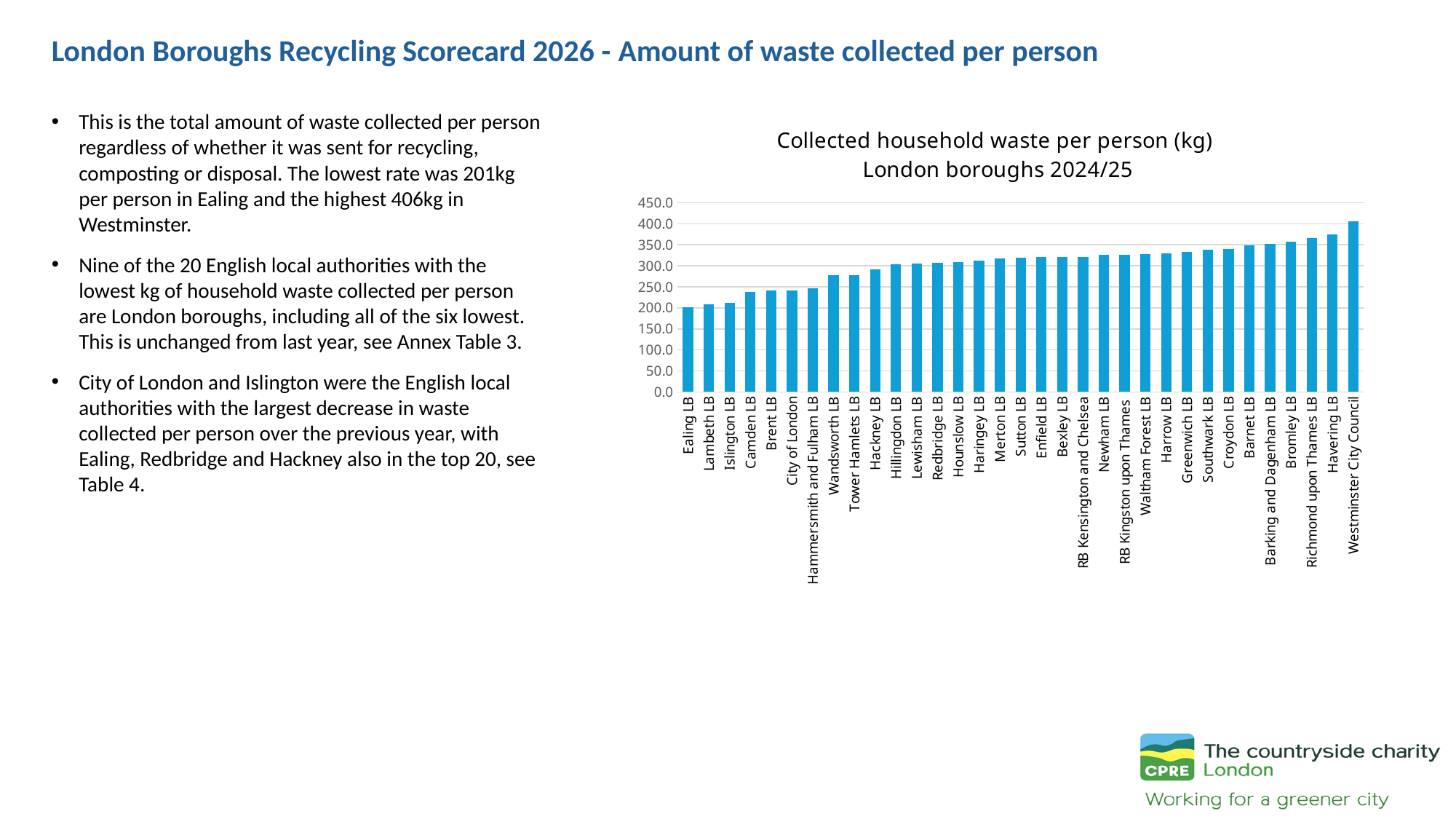
Which has the larger value, Hackney LB or Croydon LB? Croydon LB How many boroughs are plotted in the chart? 33 What is the title of the chart? Collected household waste per person (kg) London boroughs 2024/25 Which borough has the highest collected household waste per person? Westminster City Council Is the value for Ealing LB greater or less than 250? less Which has the larger value, Bromley LB or Camden LB? Bromley LB Do the bar values rise or fall from left to right along the x axis? rise Is the value for Havering LB greater or less than 350? greater Is the value for Westminster City Council greater or less than 350? greater What kind of chart is shown on the slide? bar chart Which borough has the lowest collected household waste per person? Ealing LB